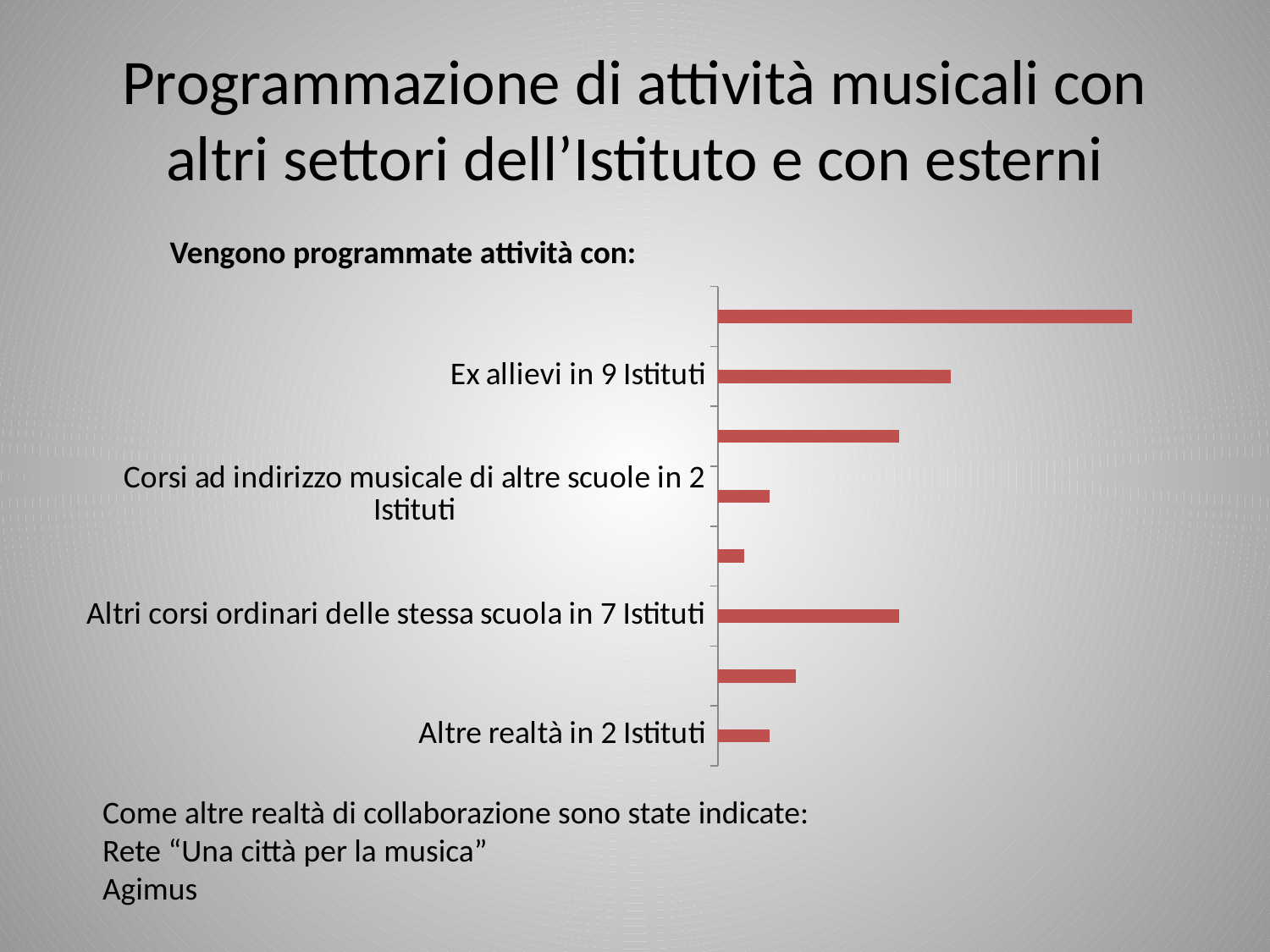
Which bar is longer: 'Altri corsi ordinari delle stessa scuola in 7 Istituti' or 'Corsi ad indirizzo musicale di altre scuole in 2 Istituti'? Altri corsi ordinari delle stessa scuola in 7 Istituti What colour are the bars in the chart? red Which bar is longer: 'Ex allievi in 9 Istituti' or 'Altre realtà in 2 Istituti'? Ex allievi in 9 Istituti Is the longest bar in the chart one of the labelled categories? No According to its category label, in how many Istituti are activities programmed with 'Ex allievi'? 9 According to its category label, in how many Istituti are activities programmed with 'Altre realtà'? 2 What is the heading printed above the chart? Vengono programmate attività con: What kind of chart is shown on the slide? bar chart Which bar is longer: 'Ex allievi in 9 Istituti' or 'Altri corsi ordinari delle stessa scuola in 7 Istituti'? Ex allievi in 9 Istituti Among the labelled categories, which has the longest bar? Ex allievi in 9 Istituti How many bars are plotted in the chart? 8 According to its category label, in how many Istituti are activities programmed with 'Altri corsi ordinari delle stessa scuola'? 7